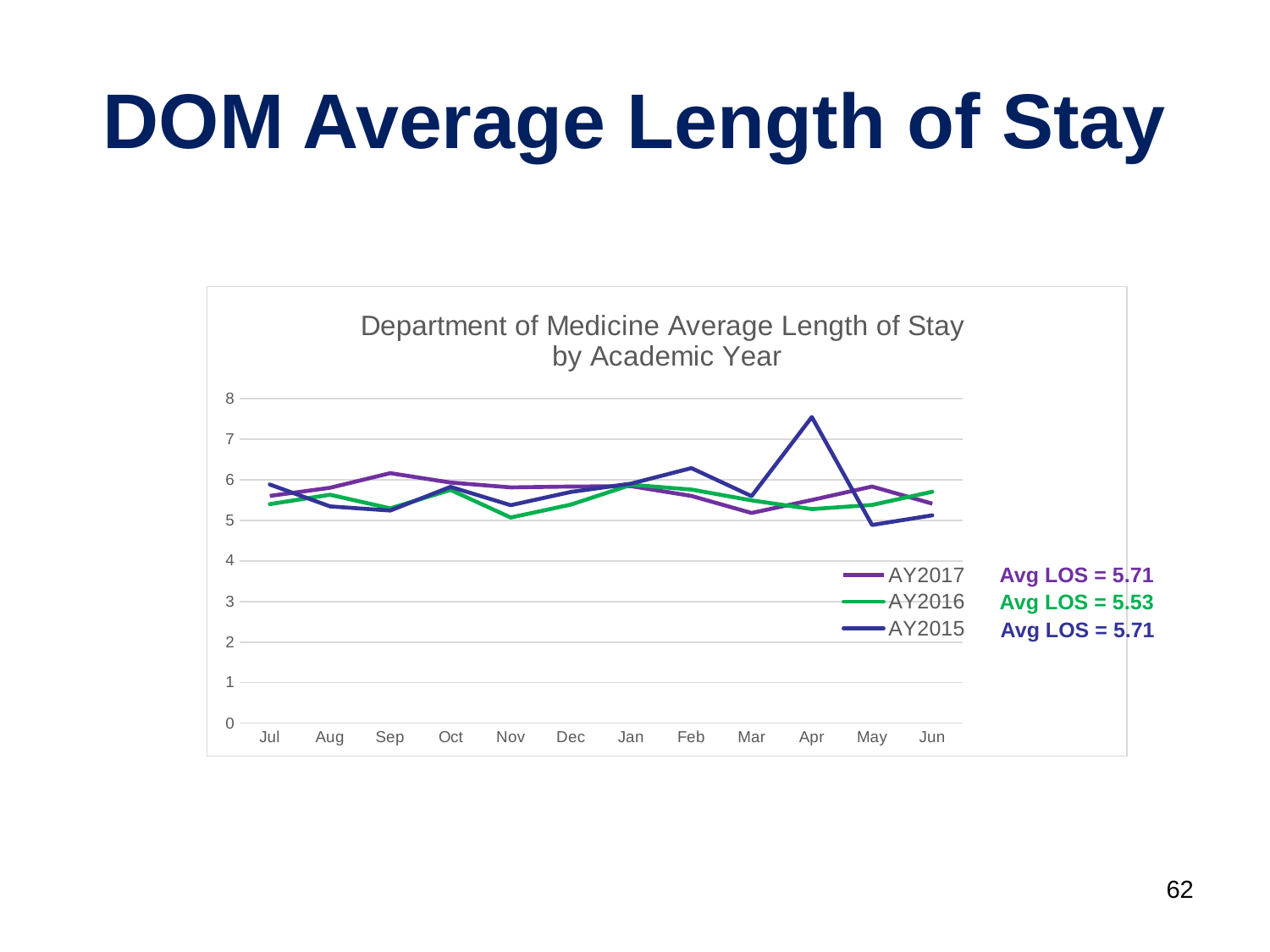
What is the title of the chart? Department of Medicine Average Length of Stay by Academic Year Is the AY2015 value for Apr greater or less than 7? greater Which series has the larger value in Sep, AY2017 or AY2016? AY2017 In which month does the AY2015 line reach its highest value? Apr Does the AY2015 line rise or fall from Apr to May? fall How many months are plotted along the x axis? 12 Is the AY2015 value for Feb greater or less than 6? greater What kind of chart is shown on the slide? line chart Is the AY2016 value for Jul greater or less than 6? less How many series does the chart legend list? 3 Which series has the larger value in Apr, AY2015 or AY2016? AY2015 What Avg LOS is shown for AY2016? 5.53